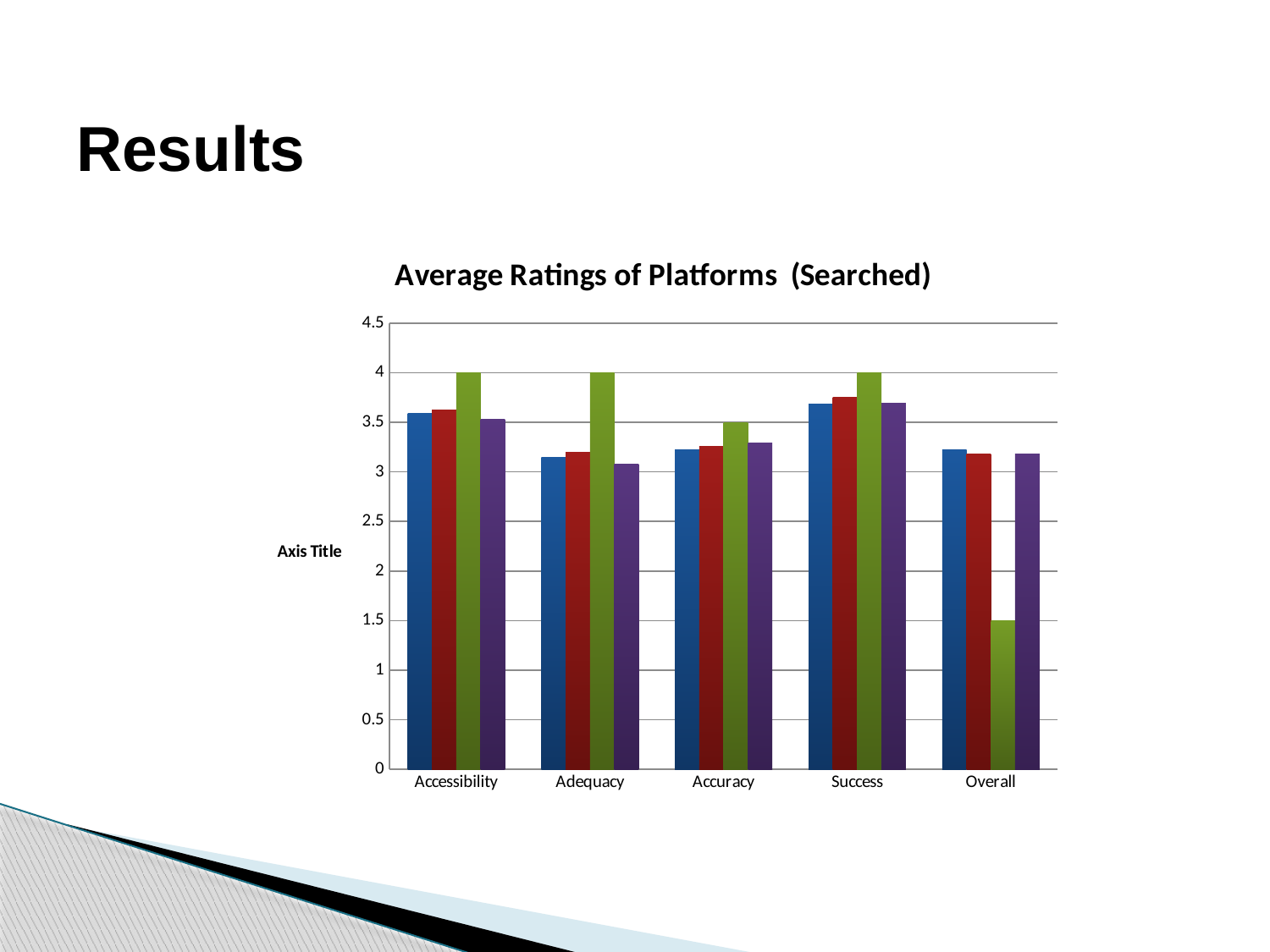
How many categories are shown on the x axis of the chart? 5 Is the value of the blue bar for Adequacy greater or less than 3.5? less What is the difference between the green bar for Accessibility and the green bar for Overall? 2.5 Which is larger: the green bar for Accessibility or the green bar for Overall? Accessibility What is the value of the green bar for Overall? 1.5 Is the value of the blue bar for Success greater or less than 3.5? greater What is the value of the green bar for Accuracy? 3.5 Among the green bars, which category has the lowest value? Overall How many bars are plotted for each category in the chart? 4 What kind of chart is shown on the slide? Bar chart What is the title of the chart? Average Ratings of Platforms (Searched) What is the value of the green bar for Accessibility? 4